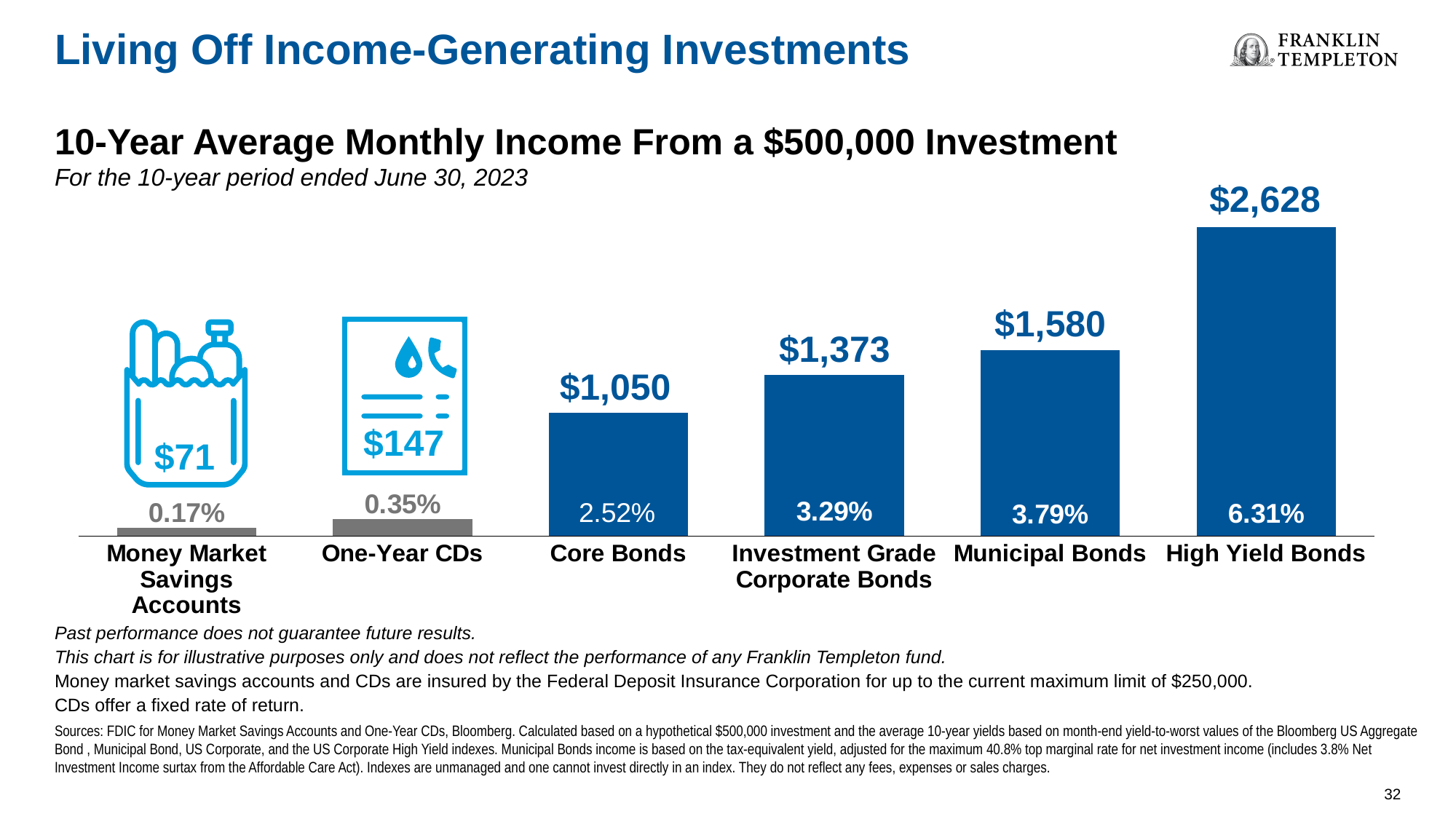
What yield percentage is shown for Municipal Bonds? 3.79% Do the monthly income values rise or fall moving from left to right across the categories? Rise Which category has the lowest average monthly income? Money Market Savings Accounts How many investment categories are shown in the chart? 6 What is the difference in monthly income between Municipal Bonds and Investment Grade Corporate Bonds? $207 What is the 10-year average monthly income from a $500,000 investment in Core Bonds? $1,050 What type of chart is shown on the slide? Bar chart Which category has the highest average monthly income? High Yield Bonds What is the title of the chart? 10-Year Average Monthly Income From a $500,000 Investment What is the monthly income shown for Money Market Savings Accounts? $71 What is the average monthly income shown for High Yield Bonds? $2,628 Which has a higher monthly income, One-Year CDs or Core Bonds? Core Bonds